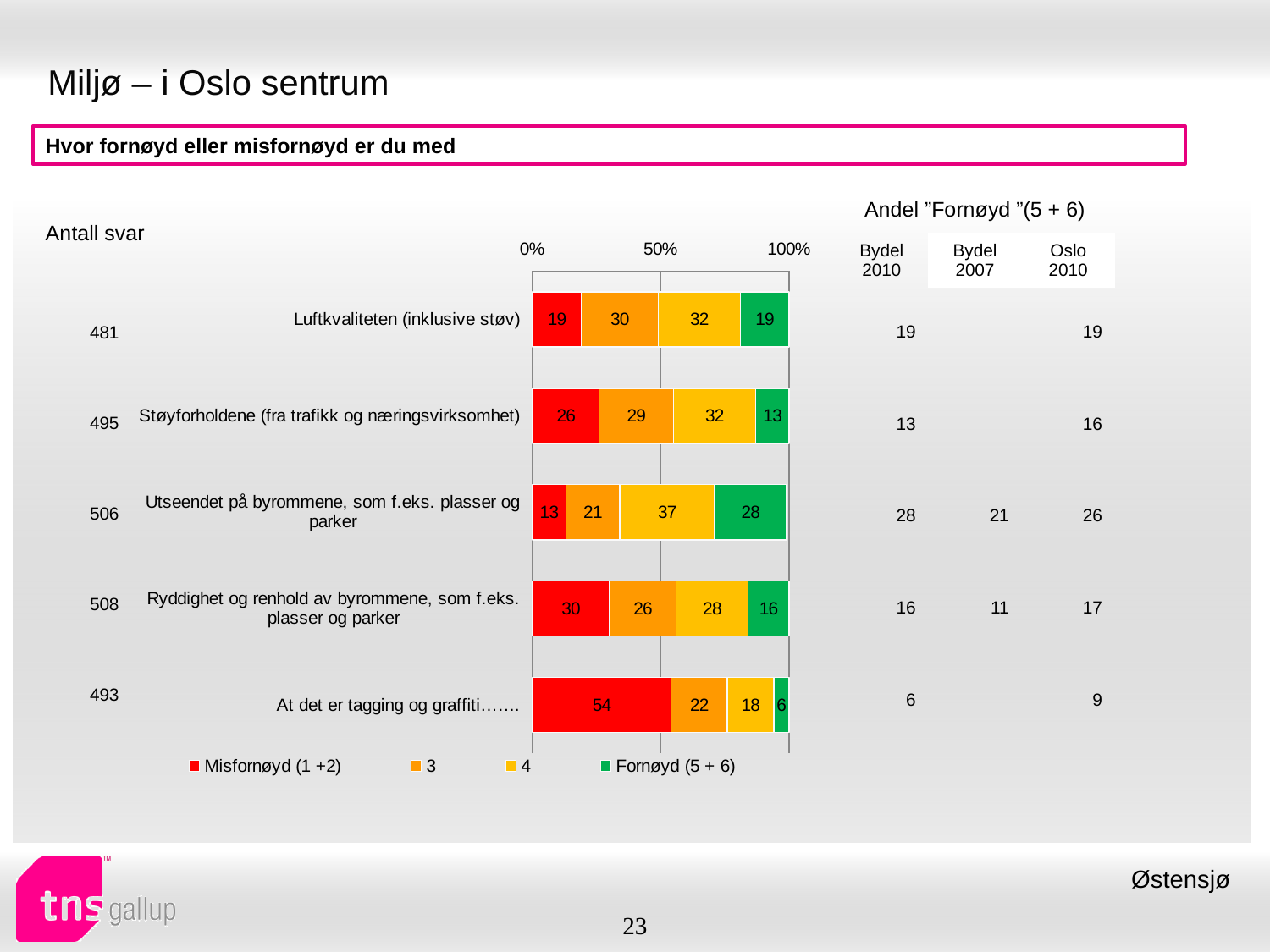
Which category has the lowest Fornøyd (5 + 6) value? At det er tagging og graffiti……. What is the value of Fornøyd (5 + 6) for "Utseendet på byrommene, som f.eks. plasser og parker"? 28 What is the value of series 3 for "Støyforholdene (fra trafikk og næringsvirksomhet)"? 29 What is the total of the stacked bar for "Luftkvaliteten (inklusive støv)"? 100 Which is larger: the Fornøyd (5 + 6) value for "Luftkvaliteten (inklusive støv)" or for "Støyforholdene (fra trafikk og næringsvirksomhet)"? Luftkvaliteten (inklusive støv) What is the difference between the Misfornøyd (1 +2) values for "Ryddighet og renhold av byrommene, som f.eks. plasser og parker" and "Luftkvaliteten (inklusive støv)"? 11 What is the value of Misfornøyd (1 +2) for "At det er tagging og graffiti……."? 54 How many categories are shown in the chart? 5 What kind of chart is shown on the slide? Stacked bar chart Which category has the highest Misfornøyd (1 +2) value? At det er tagging og graffiti……. Which colour represents Fornøyd (5 + 6) in the legend? Green How many series does the legend list? 4